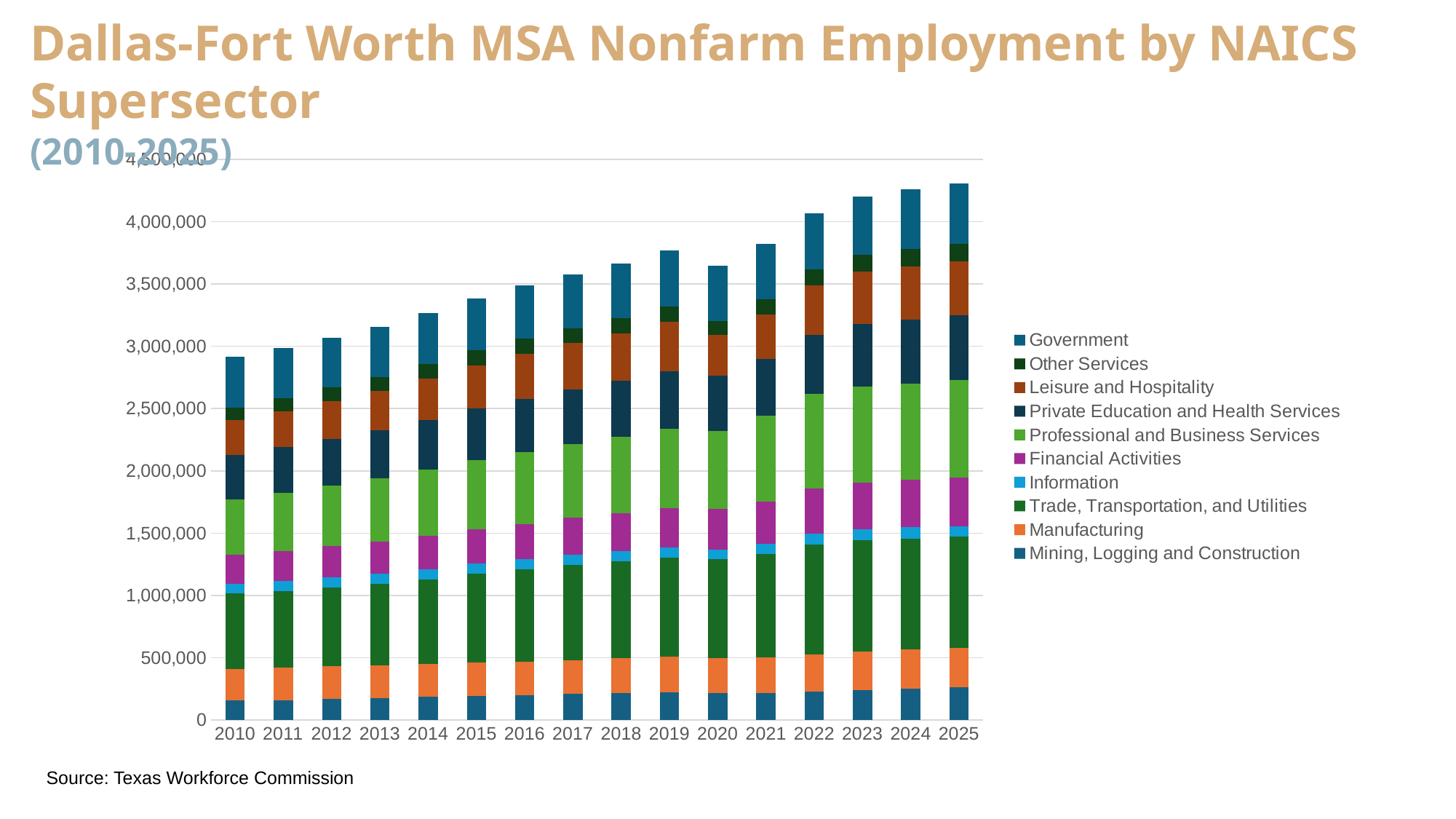
How many series does the chart's legend list? 10 Which year has a taller total bar, 2019 or 2020? 2019 What kind of chart is shown on the slide? Stacked bar chart What is the source cited for the chart's data? Texas Workforce Commission Do the total bar heights generally rise or fall from 2010 to 2025? rise Is the total bar height for 2015 greater or less than 3,500,000? less Is the total bar height for 2025 greater or less than 4,000,000? greater How many years are shown along the x axis of the chart? 16 Is the total bar height for 2010 greater or less than 3,000,000? less Which year has the lowest total nonfarm employment in the chart? 2010 Which year has the highest total nonfarm employment in the chart? 2025 Which series is listed first (at the top) in the chart's legend? Government